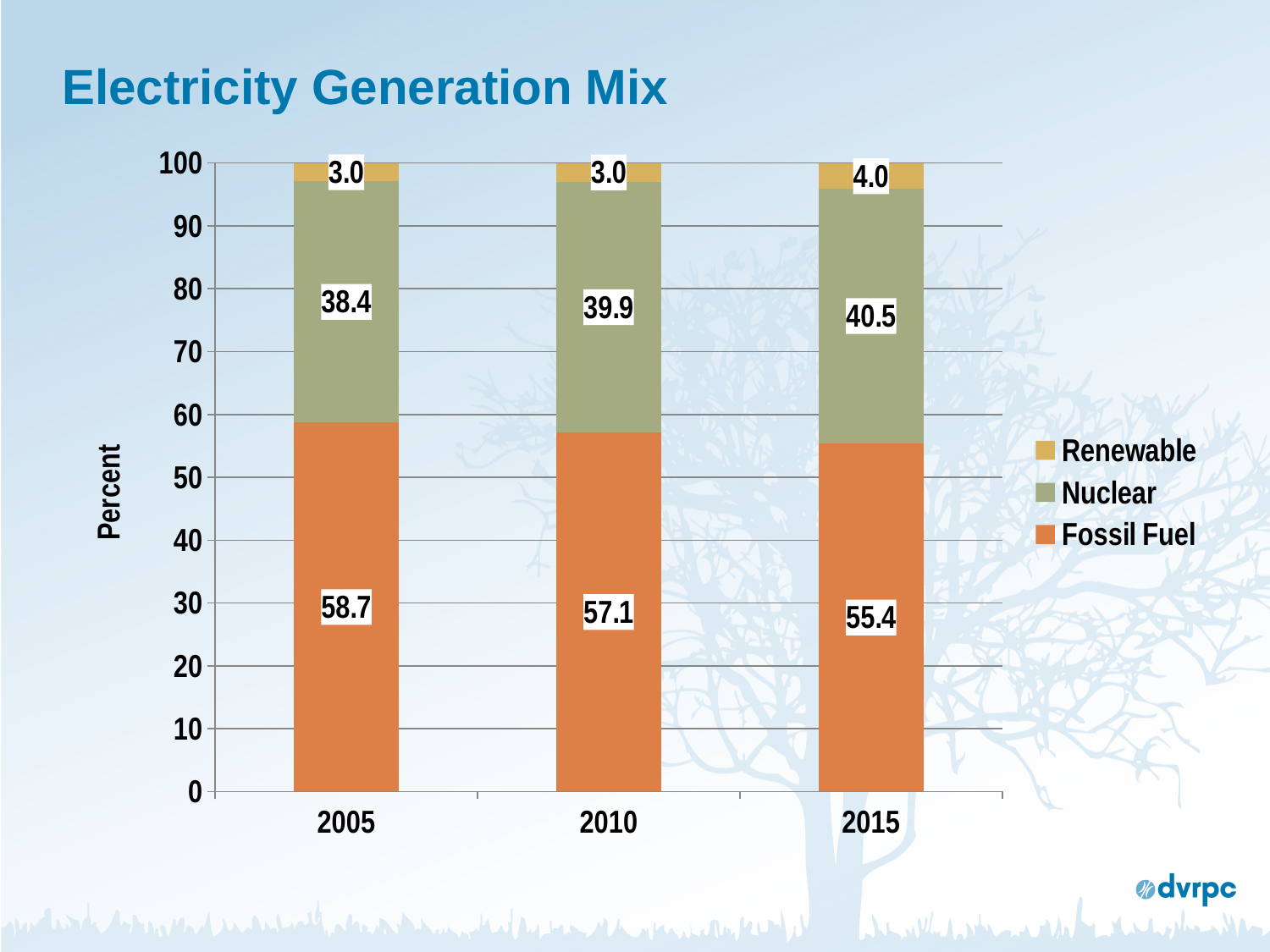
What is the difference between the Fossil Fuel values for 2005 and 2015? 3.3 What is the Nuclear value for 2015? 40.5 What is the Fossil Fuel value for 2005? 58.7 How many series does the legend list? 3 Does the Fossil Fuel value rise or fall from 2005 to 2015? Fall Is the Nuclear value larger in 2010 or in 2015? 2015 Which year has the lowest Nuclear value? 2005 Which year has the highest Fossil Fuel value? 2005 How many years are shown on the x axis? 3 What is the Renewable value for 2010? 3.0 What is the total of the stacked bar for 2015? 99.9 What kind of chart is shown? Stacked bar chart